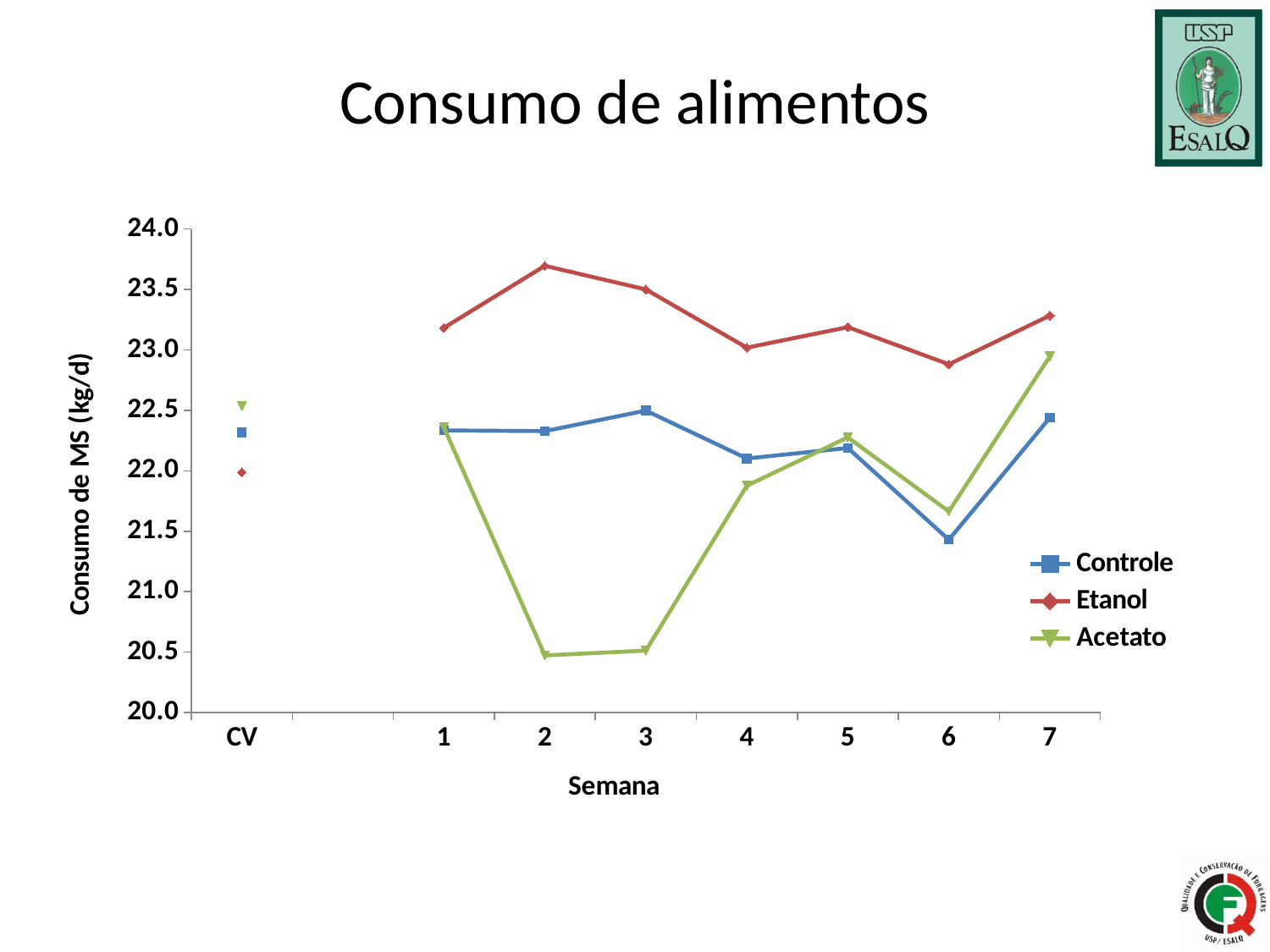
Is the value for Controle at Semana 6 greater or less than 22.0? less Which series has the lowest value at Semana 2? Acetato Is the value for Acetato at Semana 2 greater or less than 21.0? less Which series has the highest value at Semana 3? Etanol What kind of chart is shown on the slide? line chart Does the Acetato series rise or fall from Semana 3 to Semana 7? rise How many series does the legend list? 3 Is the value for Etanol at Semana 2 greater or less than 23.5? greater How many categories are shown on the x axis (including CV)? 8 What is the title of the chart? Consumo de alimentos At which Semana does the Etanol series reach its highest value? 2